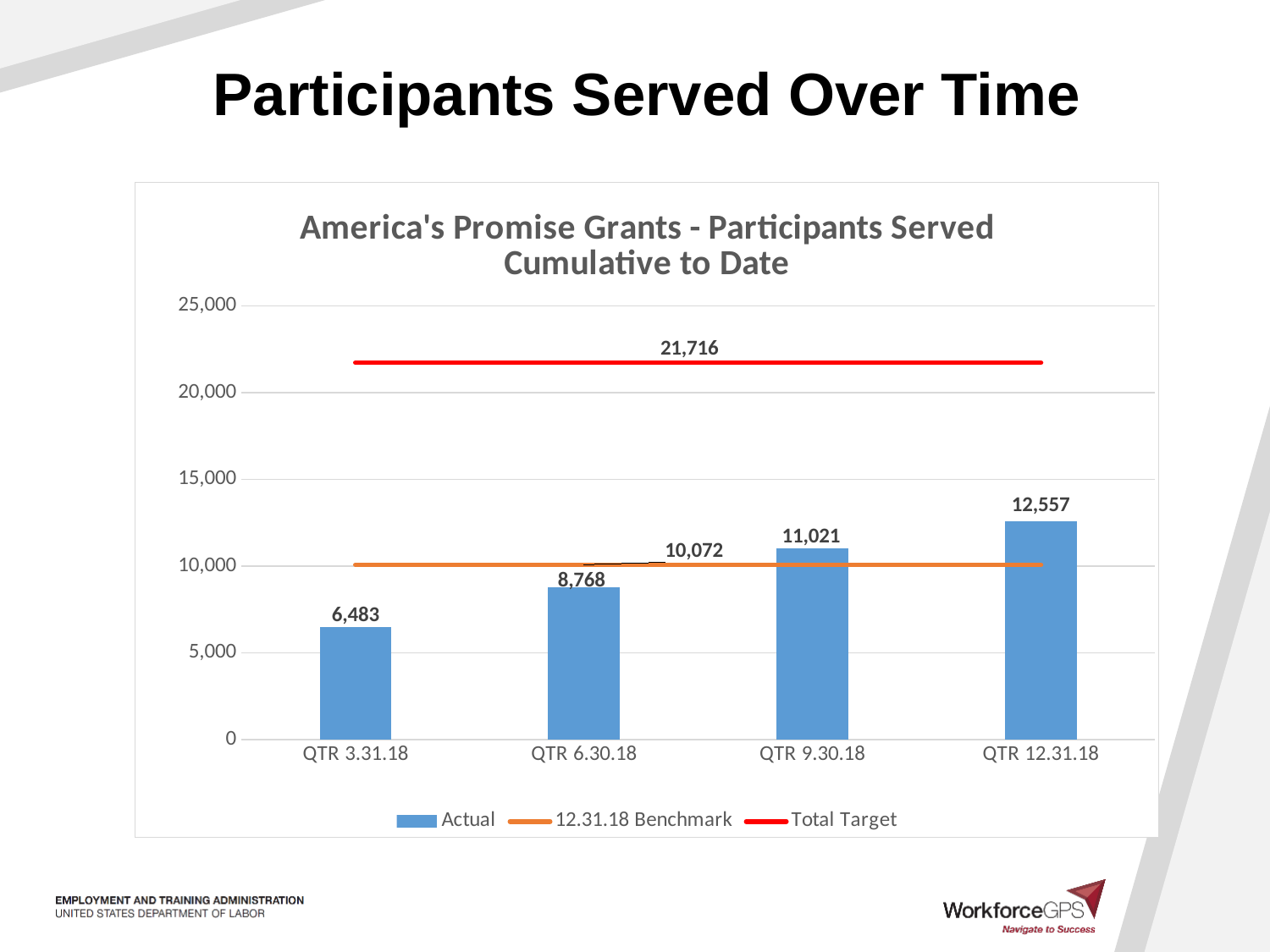
What value is shown for the Total Target line? 21,716 Is the Actual value for QTR 6.30.18 greater or less than 10,000? less What value is shown for the 12.31.18 Benchmark line? 10,072 What is the Actual value for QTR 12.31.18? 12,557 Do the Actual values rise or fall from QTR 3.31.18 to QTR 12.31.18? rise Which quarter has the lowest Actual value? QTR 3.31.18 What is the difference between the Actual values for QTR 9.30.18 and QTR 6.30.18? 2,253 How many quarters are shown on the x axis? 4 How many series does the legend list? 3 Which quarter has the highest Actual value? QTR 12.31.18 What is the Actual value for QTR 3.31.18? 6,483 Which is larger, the Actual value for QTR 9.30.18 or the 12.31.18 Benchmark? QTR 9.30.18 Actual